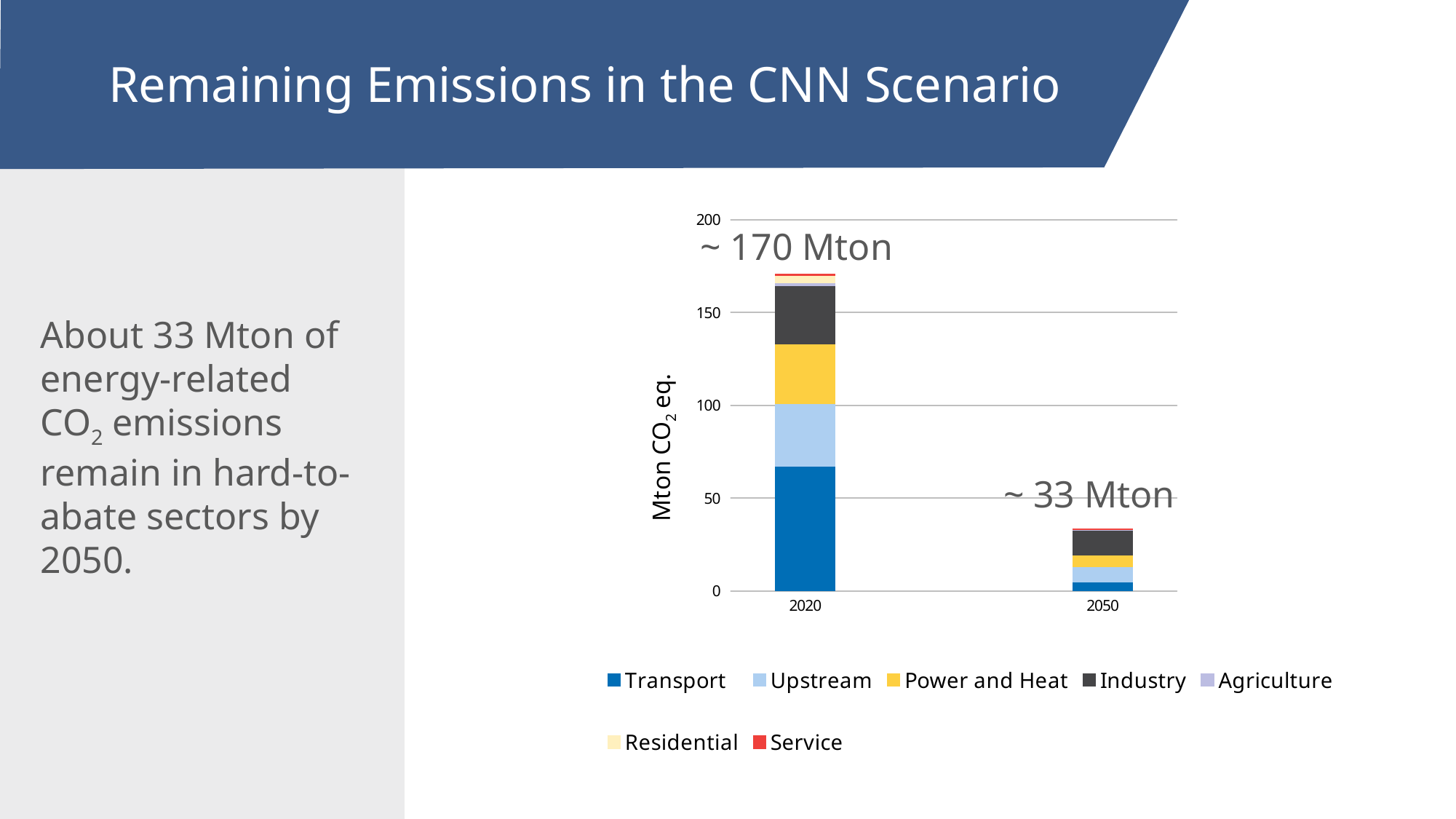
Which series has the largest segment in the 2050 bar? Industry How many years (categories) are plotted on the x axis? 2 What is the label on the y axis? Mton CO2 eq. Is the total of the 2020 bar greater or less than 150? greater What annotation text is printed above the 2020 bar? ~ 170 Mton Which year has the taller stacked bar, 2020 or 2050? 2020 How many series does the legend list? 7 Which series has the largest segment in the 2020 bar? Transport What kind of chart is shown on the slide? bar chart Is the total of the 2050 bar greater or less than 50? less Do total emissions rise or fall from 2020 to 2050? fall Is the Transport segment in 2020 greater or less than 50? greater